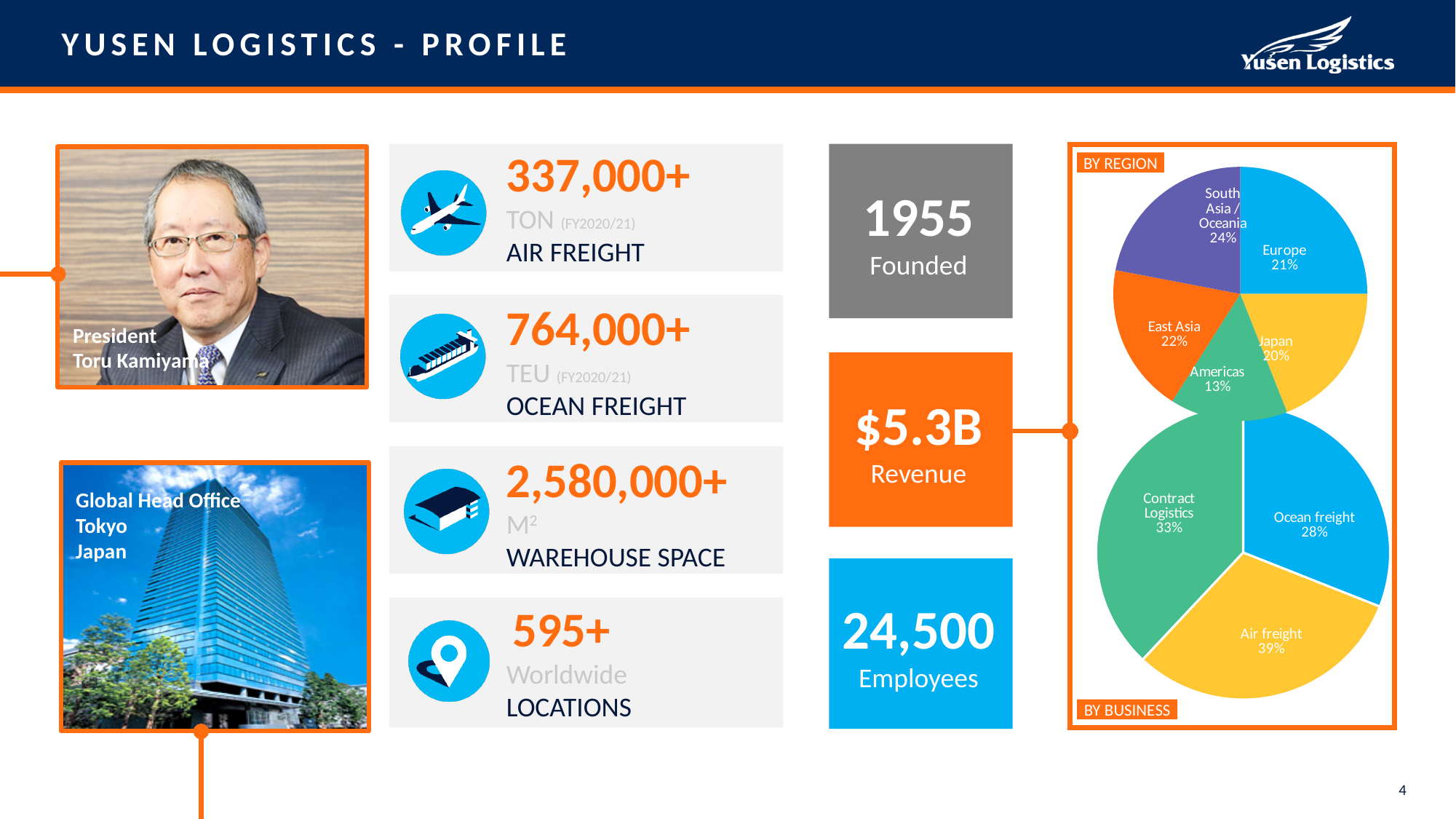
In the BY BUSINESS pie chart, what share does Air freight have? 39% In the BY REGION pie chart, what share does the Americas have? 13% In the BY REGION pie chart, what share does Europe have? 21% In the BY BUSINESS pie chart, what share does Contract Logistics have? 33% In the BY BUSINESS pie chart, which is larger, Air freight or Contract Logistics? Air freight In the BY REGION pie chart, which region has the largest share? South Asia / Oceania In the BY REGION pie chart, how many regions are shown? 5 What type of chart is the BY BUSINESS chart? Pie chart In the BY REGION pie chart, what is the difference between the East Asia share and the Japan share? 2% In the BY BUSINESS pie chart, which business segment has the smallest share? Ocean freight In the BY REGION pie chart, which region has the smallest share? Americas In the BY BUSINESS pie chart, how many business segments are shown? 3